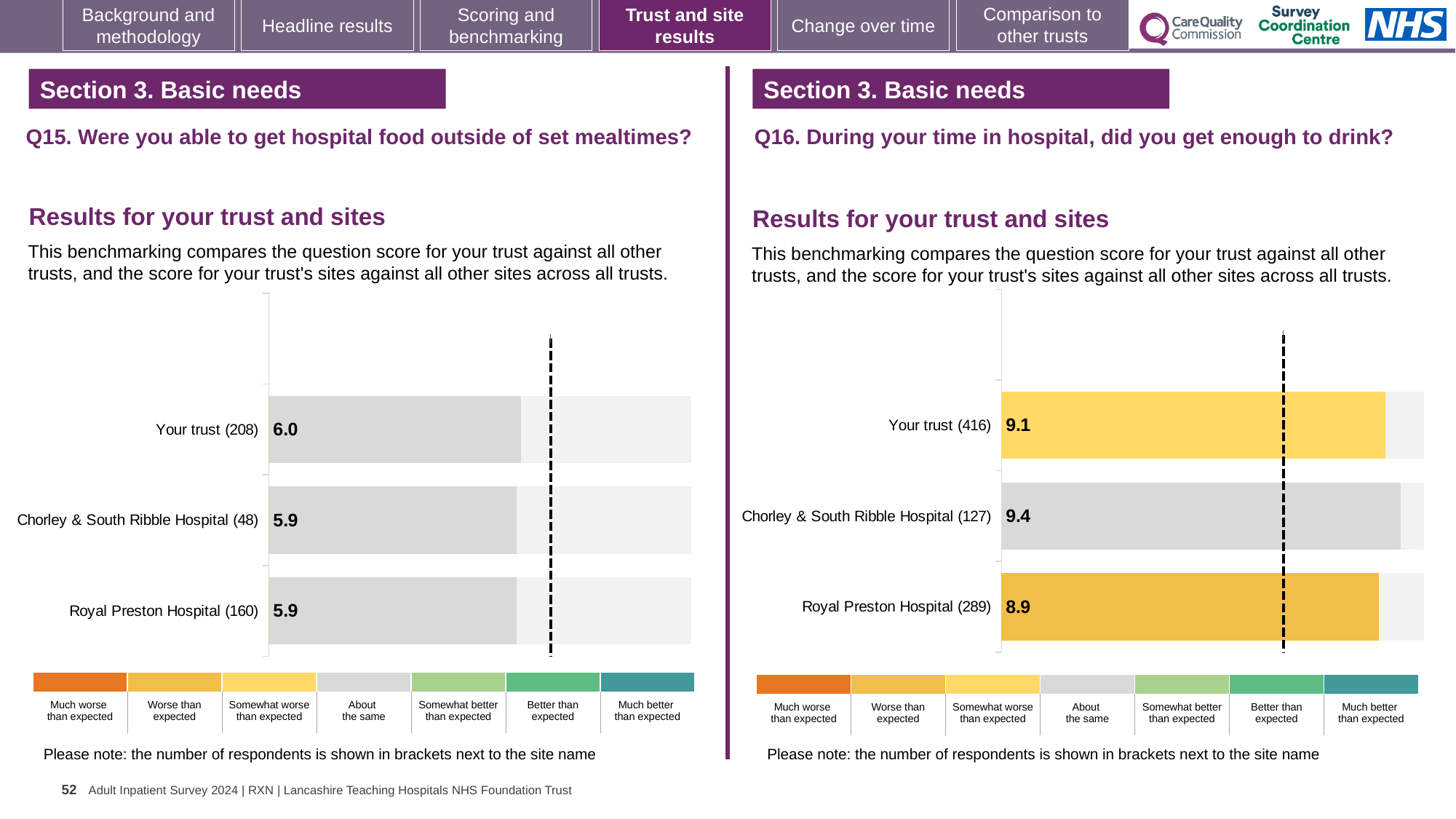
On the Q16 chart (right), what is the difference between the scores for Chorley & South Ribble Hospital and Royal Preston Hospital? 0.5 On the Q16 chart (right), what is the score for Royal Preston Hospital? 8.9 On the Q16 chart (right), what is the score for Chorley & South Ribble Hospital? 9.4 On the Q16 chart (right), which site or trust has the lowest score? Royal Preston Hospital On the Q15 chart (left), what is the score for Chorley & South Ribble Hospital? 5.9 On the Q16 chart (right), how many respondents are shown in brackets for Your trust? 416 On the Q16 chart (right), which has the larger score: Your trust or Chorley & South Ribble Hospital? Chorley & South Ribble Hospital On the Q15 chart (left), what is the difference between the score for Your trust and the score for Royal Preston Hospital? 0.1 What type of chart is used on the Q16 chart (right)? Bar chart On the Q15 chart (left), what is the score for Your trust? 6.0 How many bars are plotted on the Q15 chart (left)? 3 On the Q16 chart (right), which site or trust has the highest score? Chorley & South Ribble Hospital